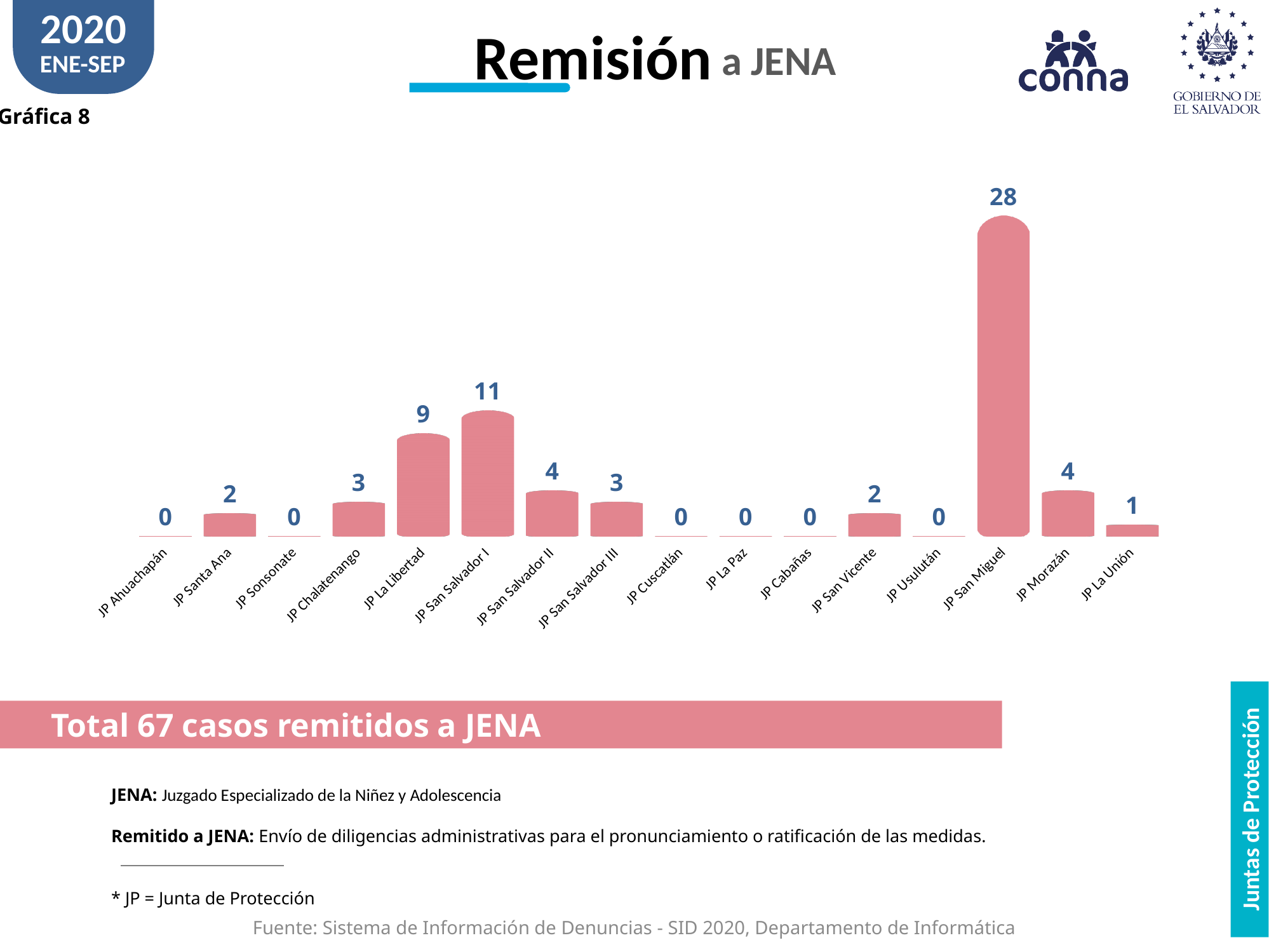
What is the difference between the values for JP San Salvador II and JP San Salvador III? 1 What kind of chart is shown on the slide? Bar chart What total number of cases remitted to JENA is stated on the slide? 67 Which is larger, the value for JP Chalatenango or the value for JP Morazán? JP Morazán What is the value for JP San Miguel? 28 What is the value for JP La Libertad? 9 Which category has the highest value? JP San Miguel What is the value for JP La Unión? 1 What is the value for JP San Salvador I? 11 How many categories are shown on the x axis? 16 How many categories have a value of 0? 6 What is the difference between the values for JP San Miguel and JP San Salvador I? 17